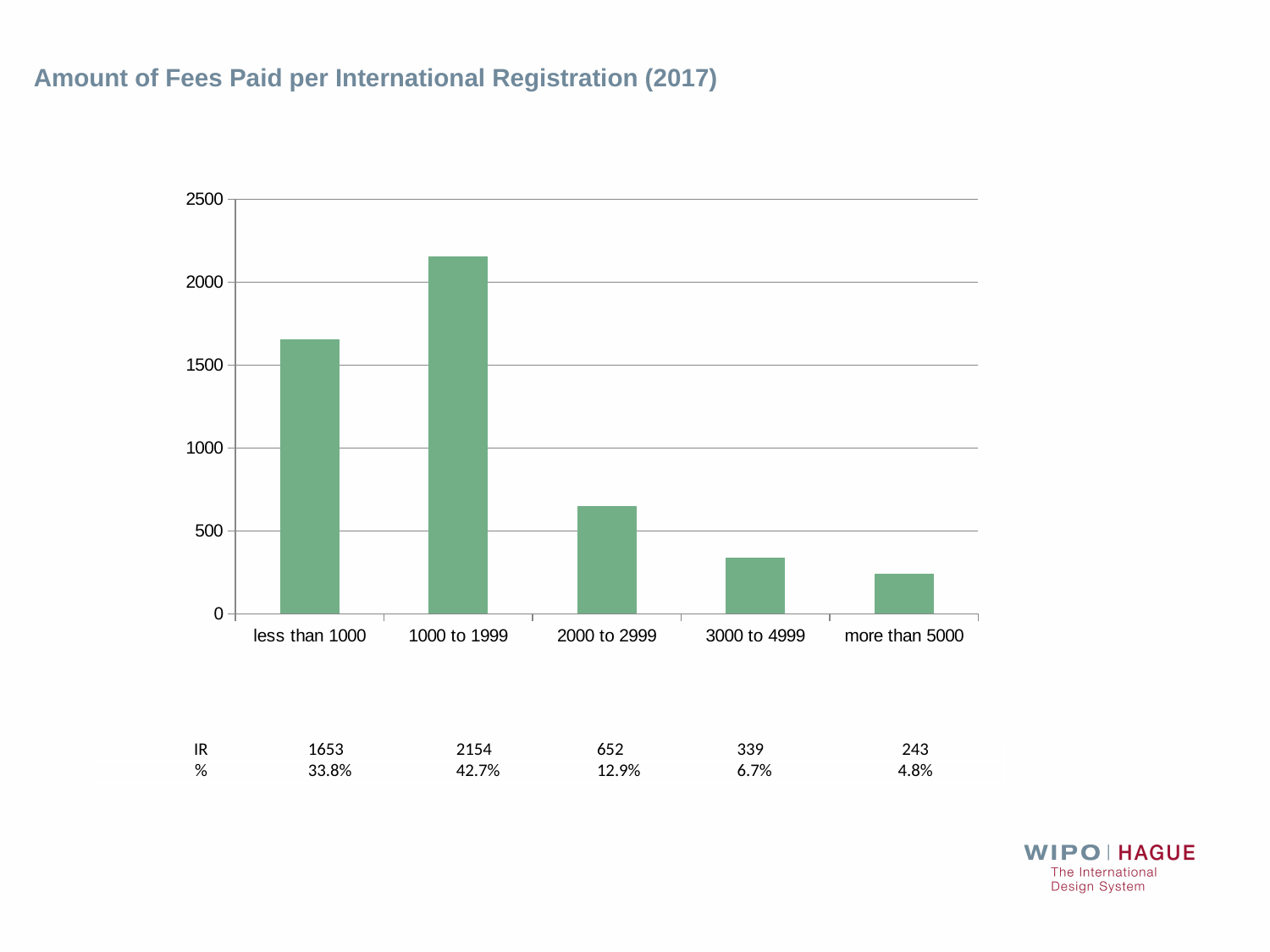
Which fee category has the lowest number of international registrations? more than 5000 How many international registrations are in the 'less than 1000' category? 1653 How many fee categories are shown on the x axis? 5 Which has more international registrations: '3000 to 4999' or 'more than 5000'? 3000 to 4999 What percentage of international registrations fall in the '3000 to 4999' category? 6.7% What is the difference in international registrations between the '1000 to 1999' and 'less than 1000' categories? 501 Do the values rise or fall from '1000 to 1999' to 'more than 5000' along the x axis? fall How many international registrations are in the '2000 to 2999' category? 652 Is the value for '1000 to 1999' greater or less than 2000? greater What is the title of the chart? Amount of Fees Paid per International Registration (2017) Which fee category has the highest number of international registrations? 1000 to 1999 What kind of chart is shown on the slide? bar chart